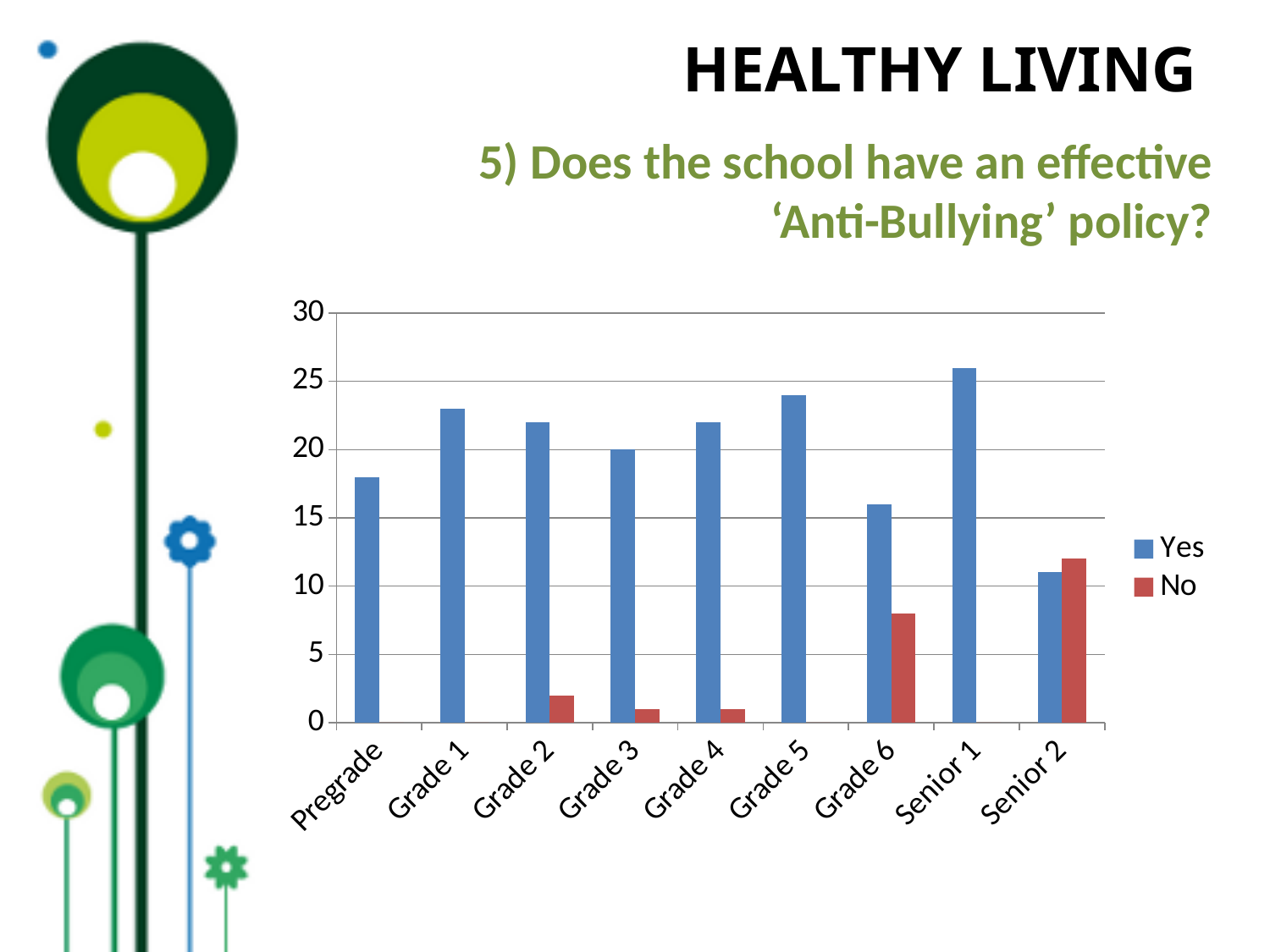
Is the Yes value for Grade 6 greater or less than 15? greater How many grade categories are shown on the x axis? 9 Which category has the highest No value? Senior 2 Is the Yes value for Senior 1 greater or less than 25? greater What is the Yes value for Grade 3? 20 For Grade 6, which is larger, the Yes value or the No value? Yes Is the No value for Grade 6 greater or less than 10? less What are the two series named in the legend? Yes and No What kind of chart is shown on the slide? bar chart Which category has the highest Yes value? Senior 1 How many series does the legend list? 2 Which category has the lowest Yes value? Senior 2